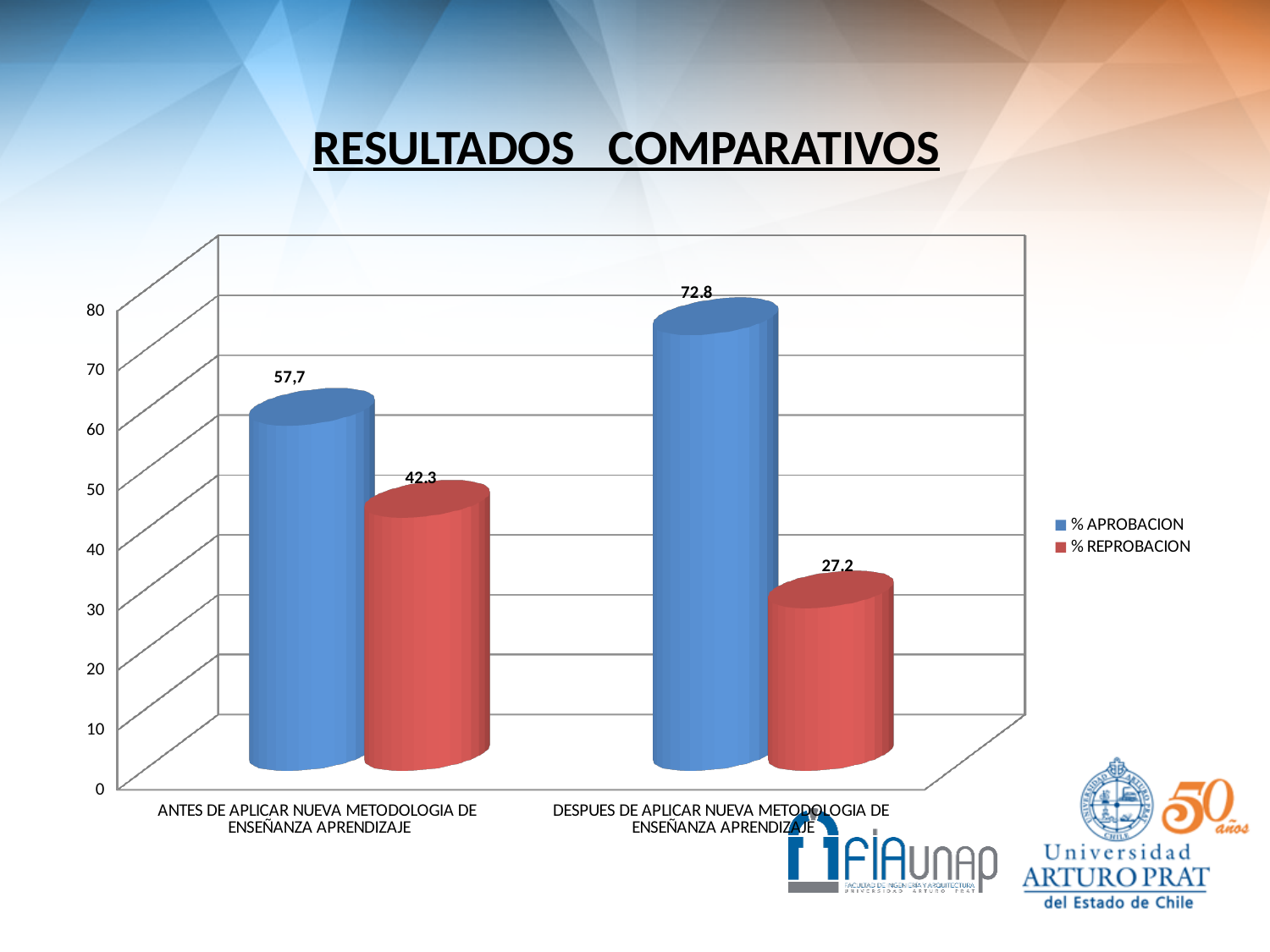
Which category has the highest % APROBACION value? DESPUES DE APLICAR NUEVA METODOLOGIA DE ENSEÑANZA APRENDIZAJE What kind of chart is shown on the slide? Bar chart What is the difference between the % APROBACION values for DESPUES and ANTES DE APLICAR NUEVA METODOLOGIA? 15,1 What is the % REPROBACION value for DESPUES DE APLICAR NUEVA METODOLOGIA DE ENSEÑANZA APRENDIZAJE? 27,2 What is the % REPROBACION value for ANTES DE APLICAR NUEVA METODOLOGIA DE ENSEÑANZA APRENDIZAJE? 42,3 What is the title of the slide? RESULTADOS COMPARATIVOS How many series does the legend list? 2 Which category has the lowest % REPROBACION value? DESPUES DE APLICAR NUEVA METODOLOGIA DE ENSEÑANZA APRENDIZAJE What is the % APROBACION value for DESPUES DE APLICAR NUEVA METODOLOGIA DE ENSEÑANZA APRENDIZAJE? 72,8 How many categories are shown on the x axis? 2 Which is larger for ANTES DE APLICAR NUEVA METODOLOGIA: % APROBACION or % REPROBACION? % APROBACION What is the % APROBACION value for ANTES DE APLICAR NUEVA METODOLOGIA DE ENSEÑANZA APRENDIZAJE? 57,7